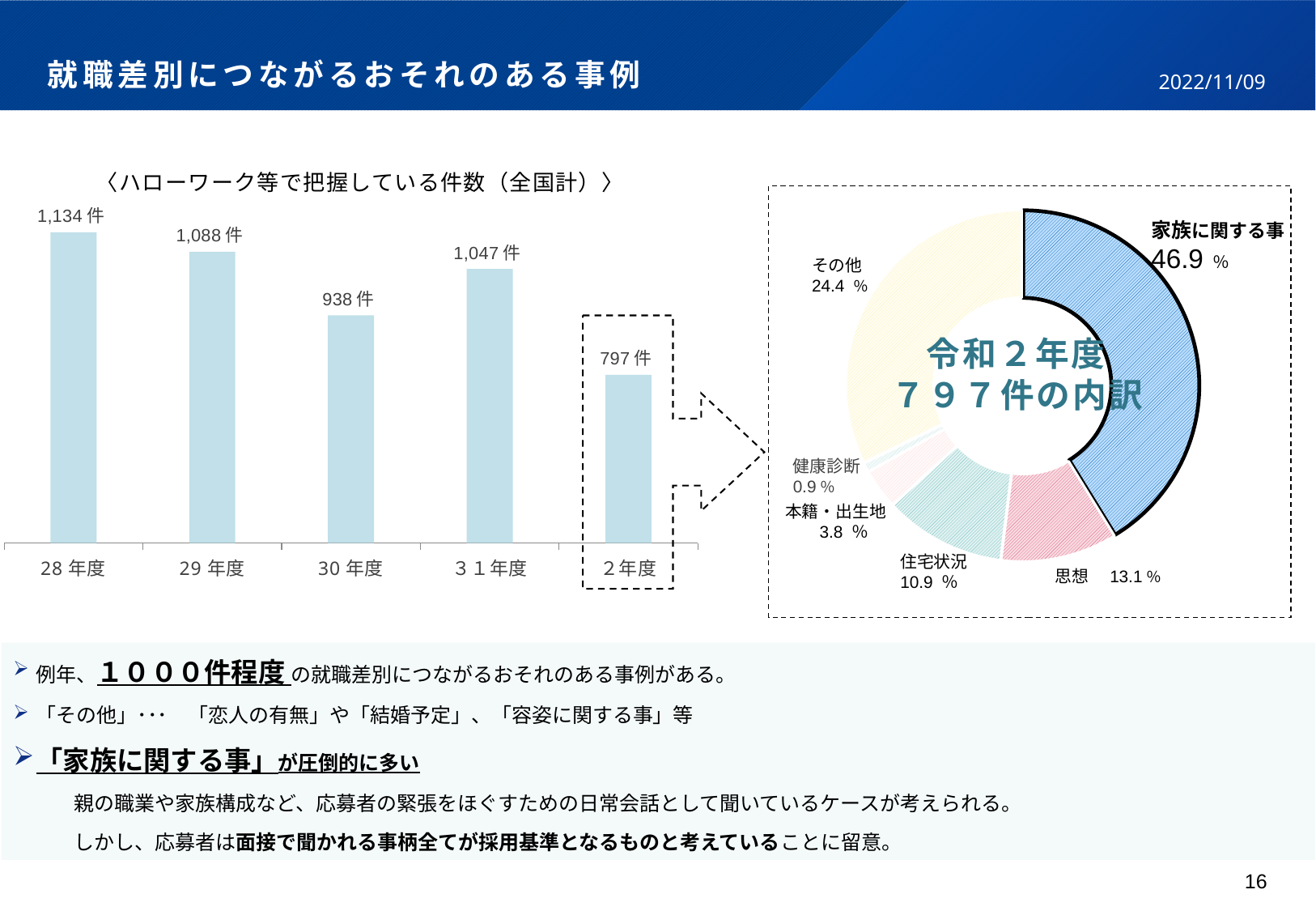
In the donut chart 令和２年度 ７９７件の内訳, what share does 家族に関する事 have? 46.9% In the bar chart 〈ハローワーク等で把握している件数（全国計）〉, which is larger, the value for 30年度 or 31年度? 31年度 In the donut chart 令和２年度 ７９７件の内訳, which category has the smallest share? 健康診断 How many categories are shown in the donut chart 令和２年度 ７９７件の内訳? 6 In the bar chart 〈ハローワーク等で把握している件数（全国計）〉, what is the value for 28年度? 1,134件 What kind of chart is the chart on the left of the slide? Bar chart In the bar chart 〈ハローワーク等で把握している件数（全国計）〉, which year has the highest value? 28年度 In the bar chart 〈ハローワーク等で把握している件数（全国計）〉, what is the value for 30年度? 938件 How many bars are shown in the bar chart 〈ハローワーク等で把握している件数（全国計）〉? 5 In the donut chart 令和２年度 ７９７件の内訳, what is the percentage for 住宅状況? 10.9% In the bar chart 〈ハローワーク等で把握している件数（全国計）〉, what is the difference between the values for 29年度 and 2年度? 291件 In the bar chart 〈ハローワーク等で把握している件数（全国計）〉, which year has the lowest value? 2年度